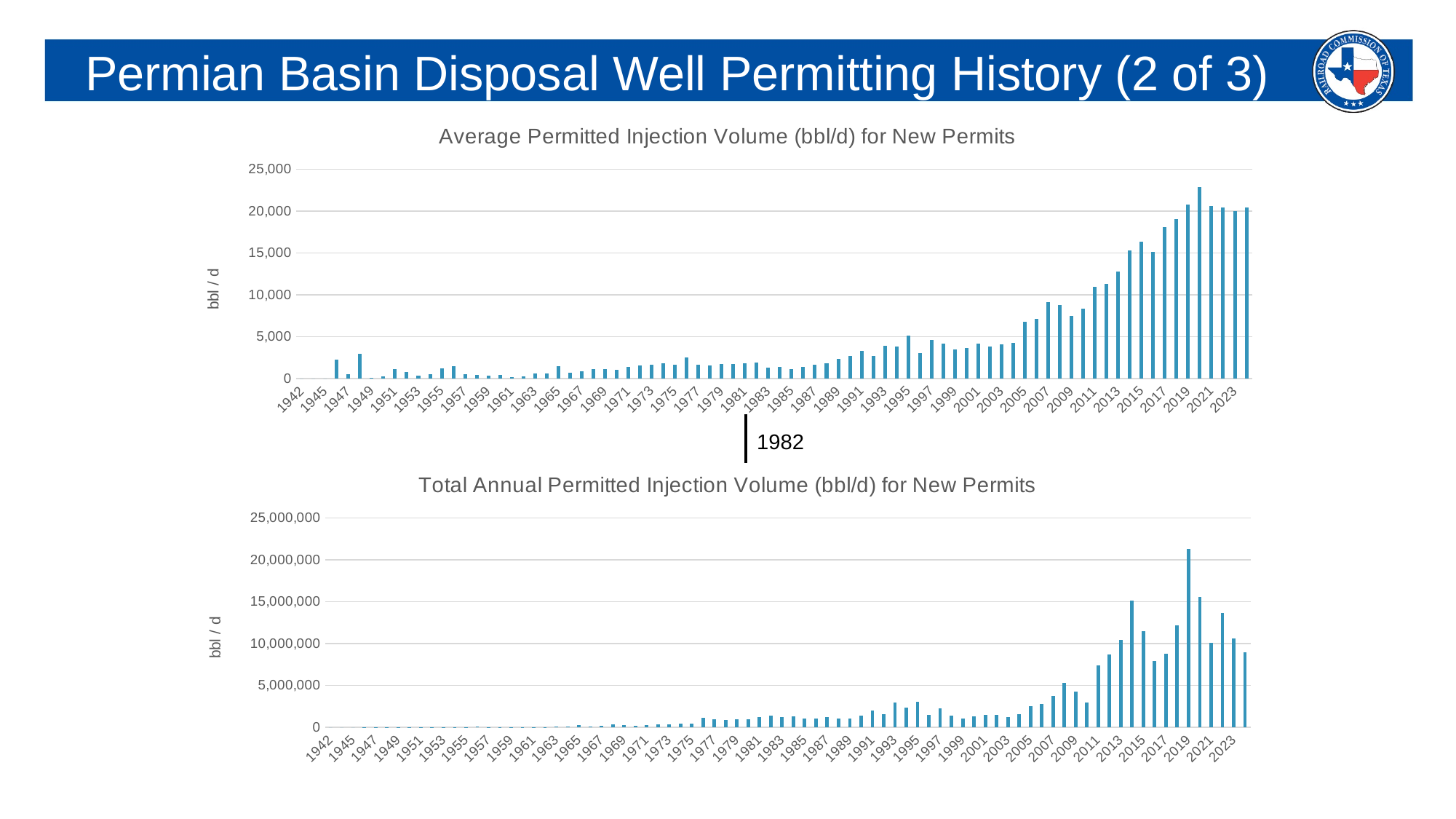
In the top chart (Average Permitted Injection Volume), is the value for 1991 greater or less than 5,000? less In the top chart (Average Permitted Injection Volume), which year has the larger value, 2017 or 2007? 2017 What kind of chart is the bottom chart, 'Total Annual Permitted Injection Volume (bbl/d) for New Permits'? bar chart In the bottom chart (Total Annual Permitted Injection Volume), is the value for 2009 greater or less than 5,000,000? less What is the y-axis label on the top chart? bbl / d In the top chart (Average Permitted Injection Volume), is the value for 2007 greater or less than 10,000? less In the top chart (Average Permitted Injection Volume), do the values generally rise or fall from 1982 to 2020? rise What kind of chart is the top chart, 'Average Permitted Injection Volume (bbl/d) for New Permits'? bar chart In the bottom chart (Total Annual Permitted Injection Volume), which year has the larger value, 2015 or 2009? 2015